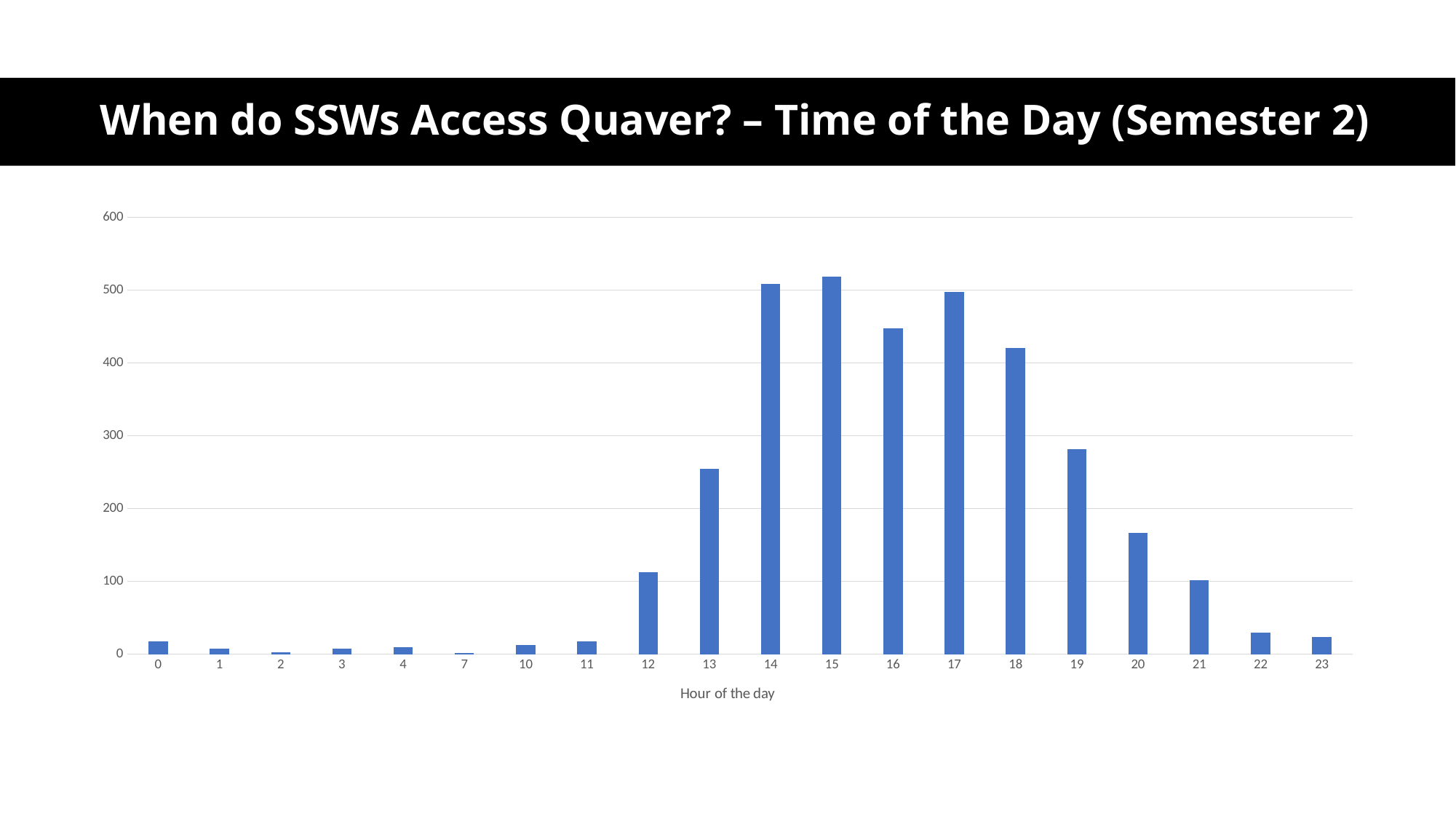
Which has the larger value, hour 13 or hour 19? Hour 19 Do the values rise or fall from hour 17 to hour 23? Fall How many hour categories are plotted on the x axis? 20 Is the value for hour 13 greater or less than 200? greater Is the value for hour 20 greater or less than 100? greater What is the title of the x axis? Hour of the day Is the value for hour 16 greater or less than 500? less What kind of chart is shown on the slide? Bar chart What is the title of the slide? When do SSWs Access Quaver? – Time of the Day (Semester 2) Which has the larger value, hour 12 or hour 20? Hour 20